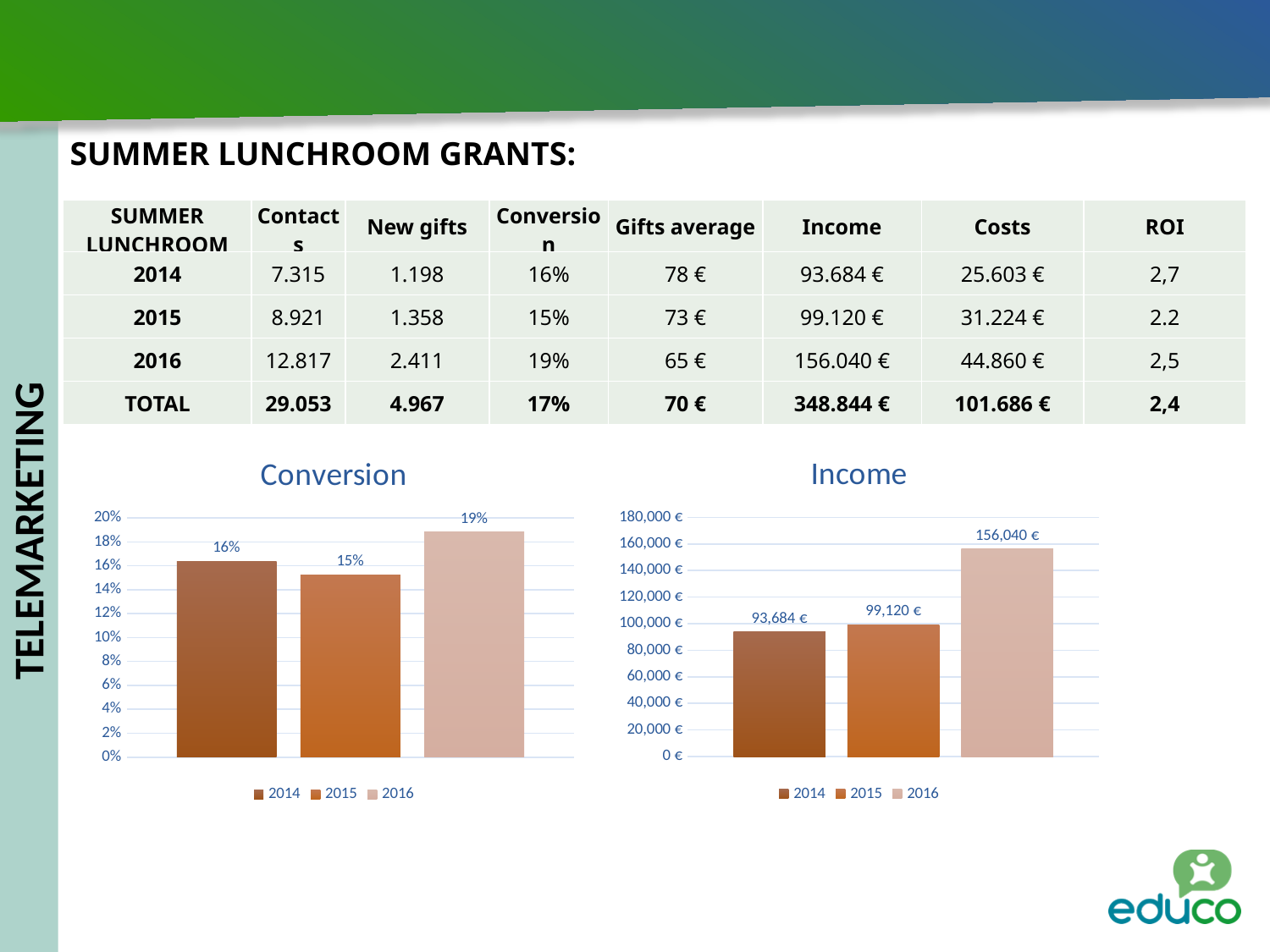
In the Income chart, is the value for 2016 greater or less than 140,000 €? greater In the Income chart, what is the value for 2015? 99,120 € In the Income chart, which is larger, the value for 2014 or the value for 2015? 2015 In the Conversion chart, what is the value for 2016? 19% What kind of chart is the Conversion chart? bar chart In the Conversion chart, which year has the lowest conversion? 2015 In the Conversion chart, is the value for 2014 greater or less than 10%? greater How many entries does the legend of the Income chart list? 3 In the Income chart, which year has the highest income? 2016 How many bars are plotted in the Income chart? 3 In the Conversion chart, what is the difference between the 2016 and 2015 values? 4% In the Income chart, what is the difference between the 2016 and 2014 values? 62,356 €